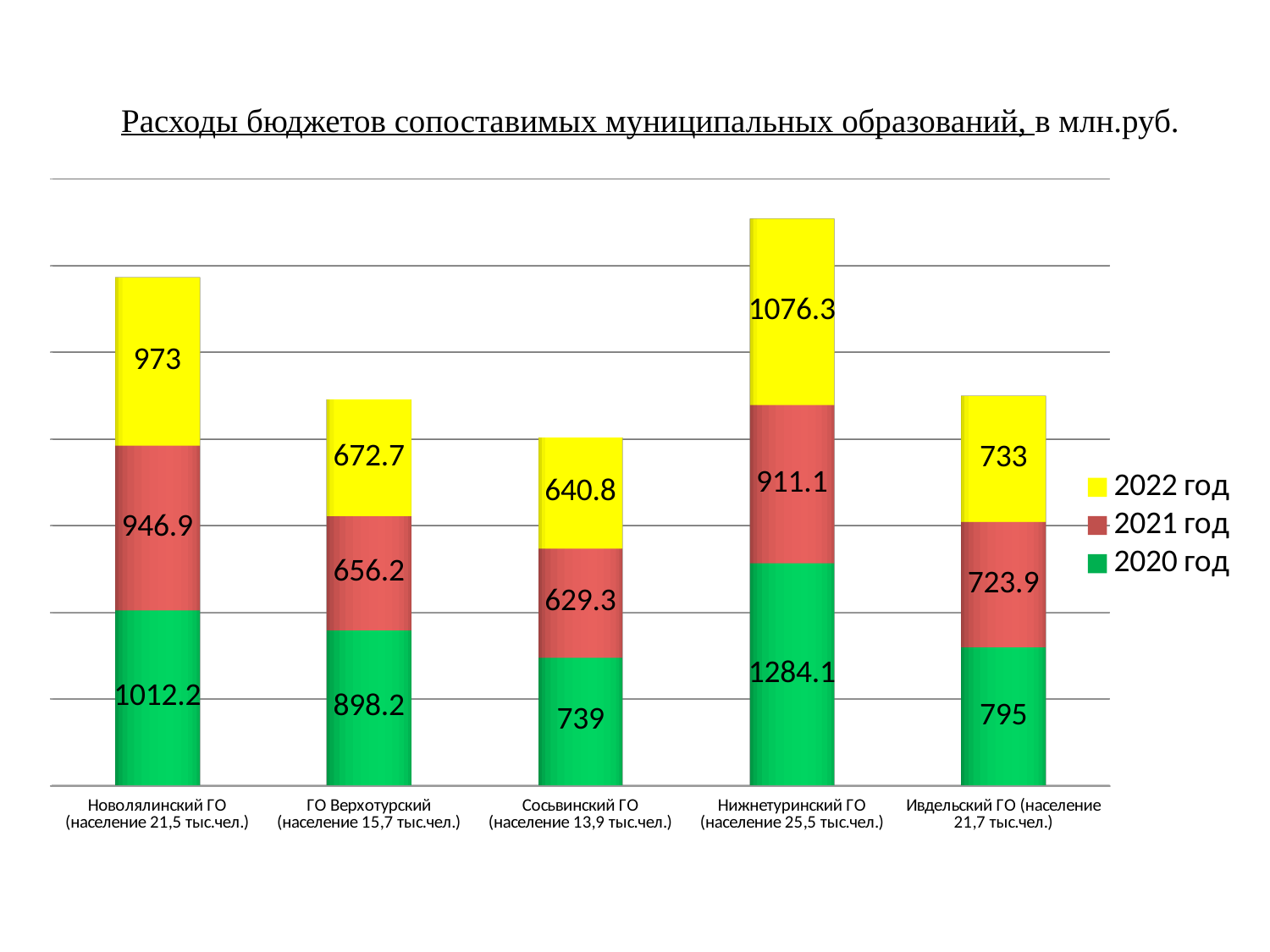
Which colour represents 2021 год in the legend? red What is the 2021 год value for Ивдельский ГО? 723.9 How many series does the legend list? 3 What is the 2022 год value for ГО Верхотурский? 672.7 How many municipalities (categories) are shown on the x axis? 5 What is the 2020 год value for Нижнетуринский ГО? 1284.1 What is the difference between the 2020 год values for Нижнетуринский ГО and Новолялинский ГО? 271.9 What is the total of the stacked bar for Сосьвинский ГО? 2009.1 Which municipality has the highest 2022 год value? Нижнетуринский ГО Which municipality has the lowest 2020 год value? Сосьвинский ГО Which is larger: the 2021 год value for Новолялинский ГО or the 2021 год value for Нижнетуринский ГО? Новолялинский ГО What type of chart is shown on the slide? stacked bar chart